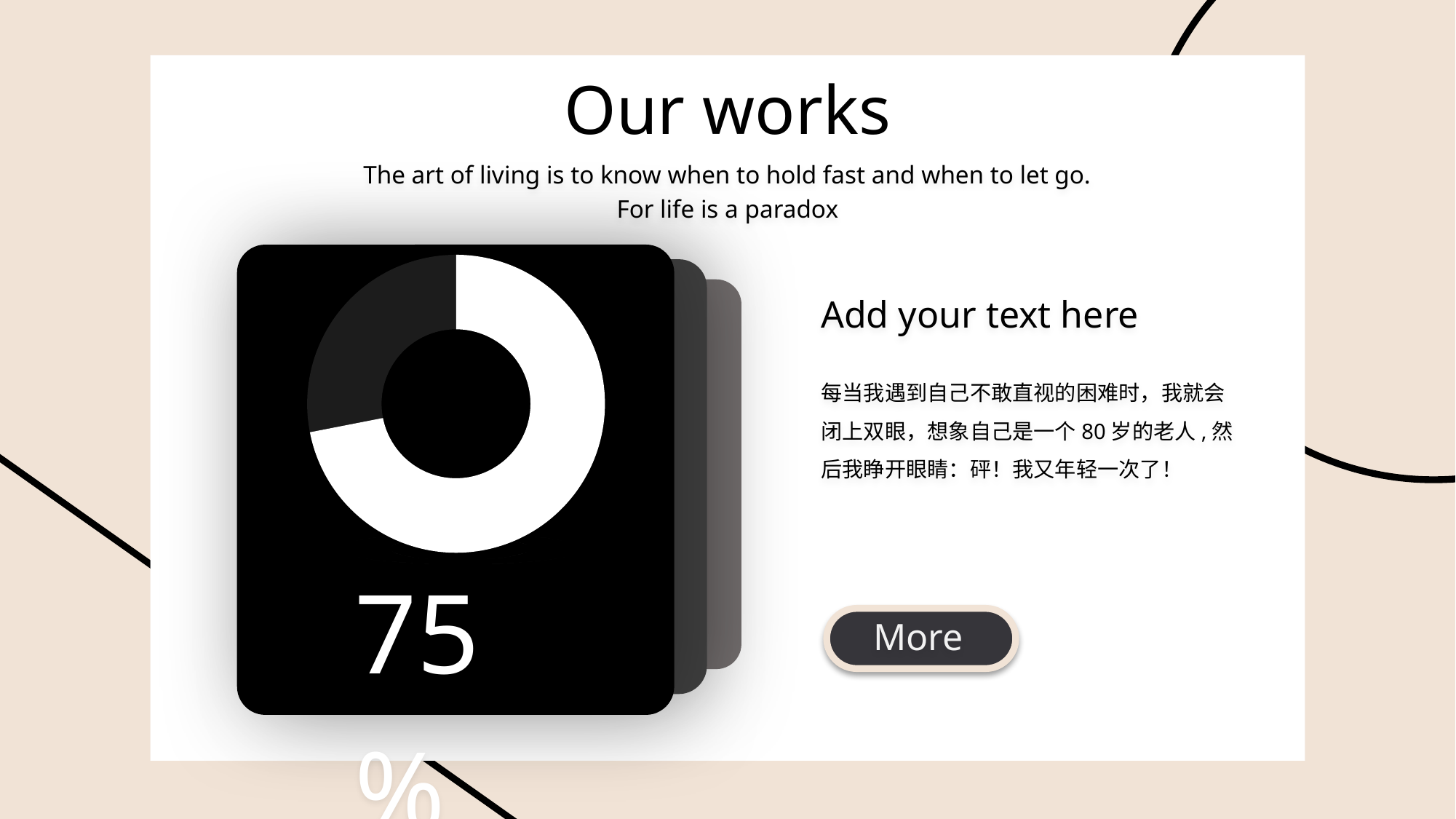
Which slice of the doughnut chart is the smallest? the dark grey slice What percentage is printed below the doughnut chart? 75% What is the title of the slide containing the doughnut chart? Our works Is the white slice of the doughnut chart greater or less than half of the chart? greater What kind of chart is shown on the slide? doughnut chart Which slice of the doughnut chart is the largest? the white slice What colour is the background of the card containing the doughnut chart? black Which slice of the doughnut chart is larger, the white one or the dark grey one? white How many slices does the doughnut chart have? 2